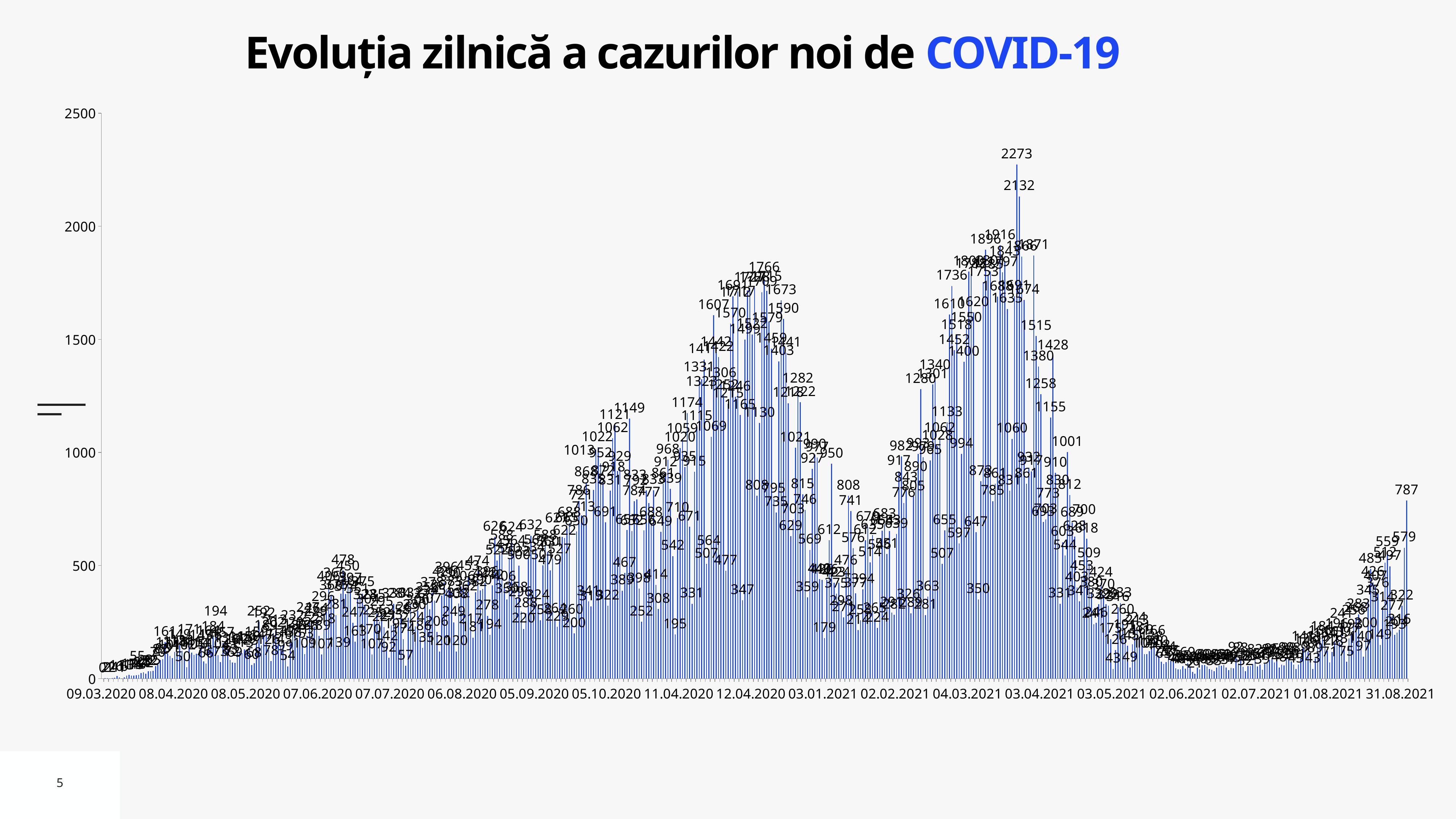
Which is larger, the peak value 2273 or the peak value 1766? 2273 What kind of chart is shown on the slide? bar chart What is the first date shown on the x axis? 09.03.2020 What is the title of the chart? Evoluția zilnică a cazurilor noi de COVID-19 Between 02.07.2021 and 31.08.2021, do the values generally rise or fall? rise What is the highest tick value on the y axis? 2500 What is the second-highest daily value labelled on the chart, next to the 2273 peak? 2132 What is the difference between the two highest labelled values, 2273 and 2132? 141 Are the values around 02.06.2021 greater or less than 500? less Is the highest value on the chart greater or less than 2000? greater How many tick labels are shown on the y axis? 6 What is the highest daily value labelled on the chart? 2273